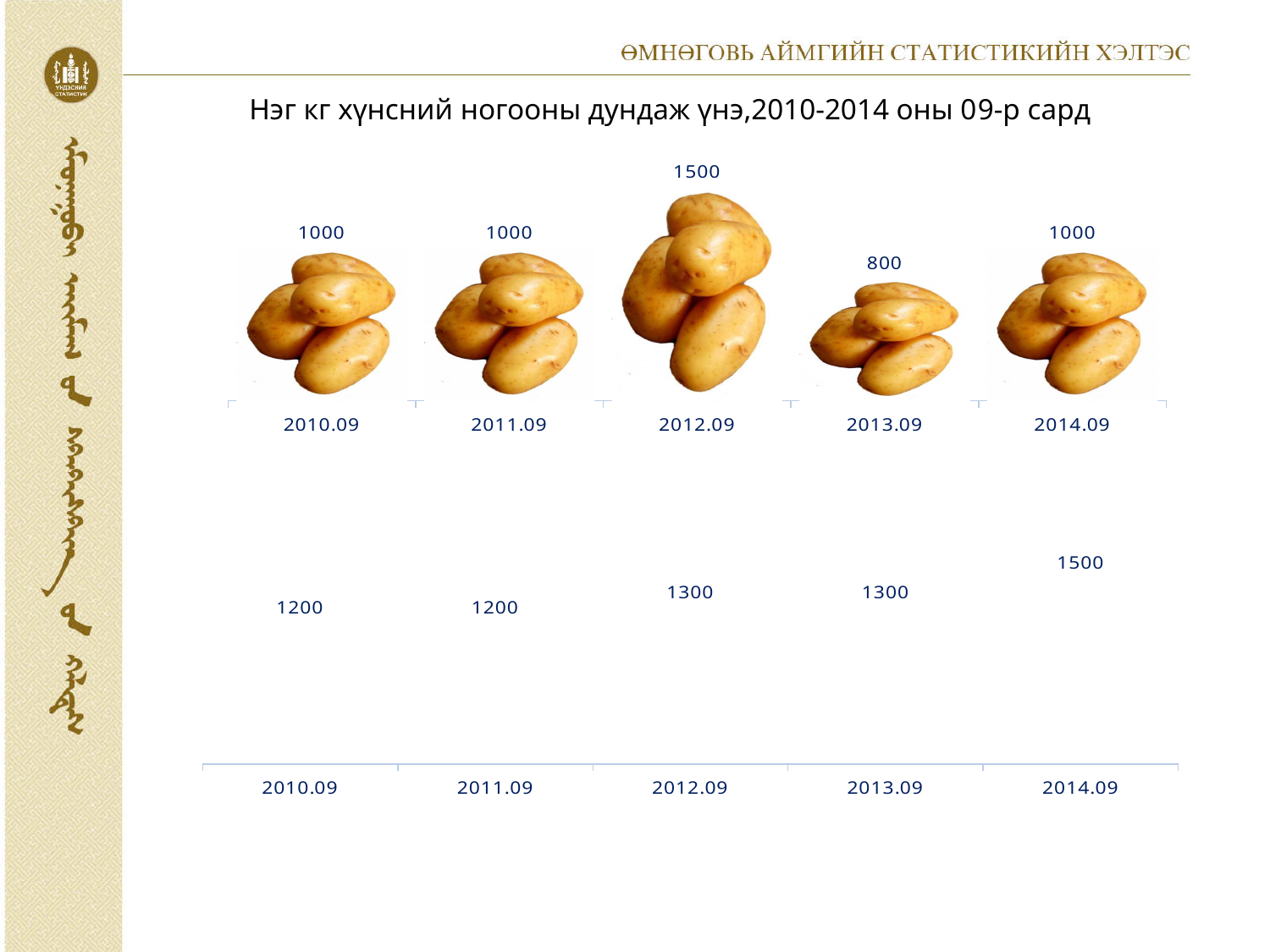
In the bottom chart, which period has the highest labelled value? 2014.09 In the top chart (potato pictures), what is the value for 2012.09? 1500 In the top chart (potato pictures), which period has the lowest value? 2013.09 In the bottom chart, do the labelled values rise or fall from 2010.09 to 2014.09? rise In the top chart (potato pictures), is the value for 2014.09 larger or smaller than the value for 2013.09? larger In the top chart (potato pictures), what is the value for 2013.09? 800 In the bottom chart, what is the value labelled for 2014.09? 1500 In the top chart (potato pictures), what is the difference between the values for 2012.09 and 2013.09? 700 In the bottom chart, what is the difference between the labelled values for 2014.09 and 2011.09? 300 How many periods are shown on the x axis of the top chart (potato pictures)? 5 In the top chart (potato pictures), which period has the highest value? 2012.09 In the bottom chart, what is the value labelled for 2010.09? 1200